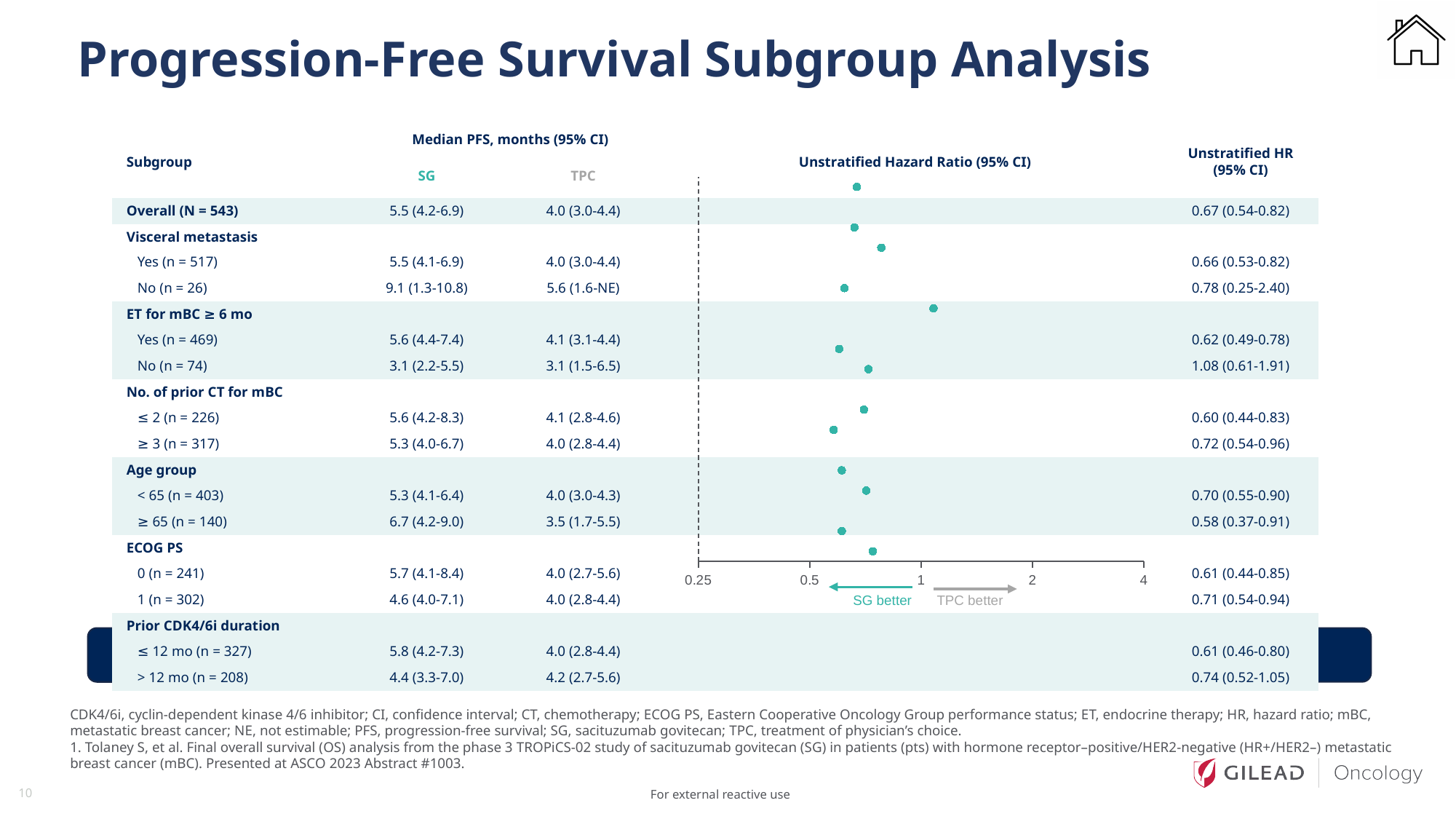
Which subgroup has the highest unstratified hazard ratio point estimate? ET for mBC ≥ 6 mo, No (n = 74) What kind of chart is used to display the unstratified hazard ratios? Forest plot What is the unstratified hazard ratio (95% CI) for the Age group ≥ 65 (n = 140) subgroup? 0.58 (0.37-0.91) What is the unstratified hazard ratio (95% CI) for the ET for mBC ≥ 6 mo, No (n = 74) subgroup? 1.08 (0.61-1.91) Which subgroup has the lowest unstratified hazard ratio point estimate? Age group ≥ 65 (n = 140) What is the unstratified hazard ratio (95% CI) for the Overall (N = 543) group? 0.67 (0.54-0.82) Which direction on the hazard ratio axis is labelled as favouring SG? Left (SG better) How many hazard ratio points are plotted in the forest plot? 13 What tick values are shown on the hazard ratio axis? 0.25, 0.5, 1, 2, 4 Is the hazard ratio point estimate for the ET for mBC ≥ 6 mo, No (n = 74) subgroup greater or less than 1? greater Which has the larger hazard ratio point estimate: Age group < 65 (n = 403) or Age group ≥ 65 (n = 140)? < 65 (n = 403) What is the difference between the hazard ratio point estimates for ≥ 3 (n = 317) and ≤ 2 (n = 226) prior CT for mBC? 0.12